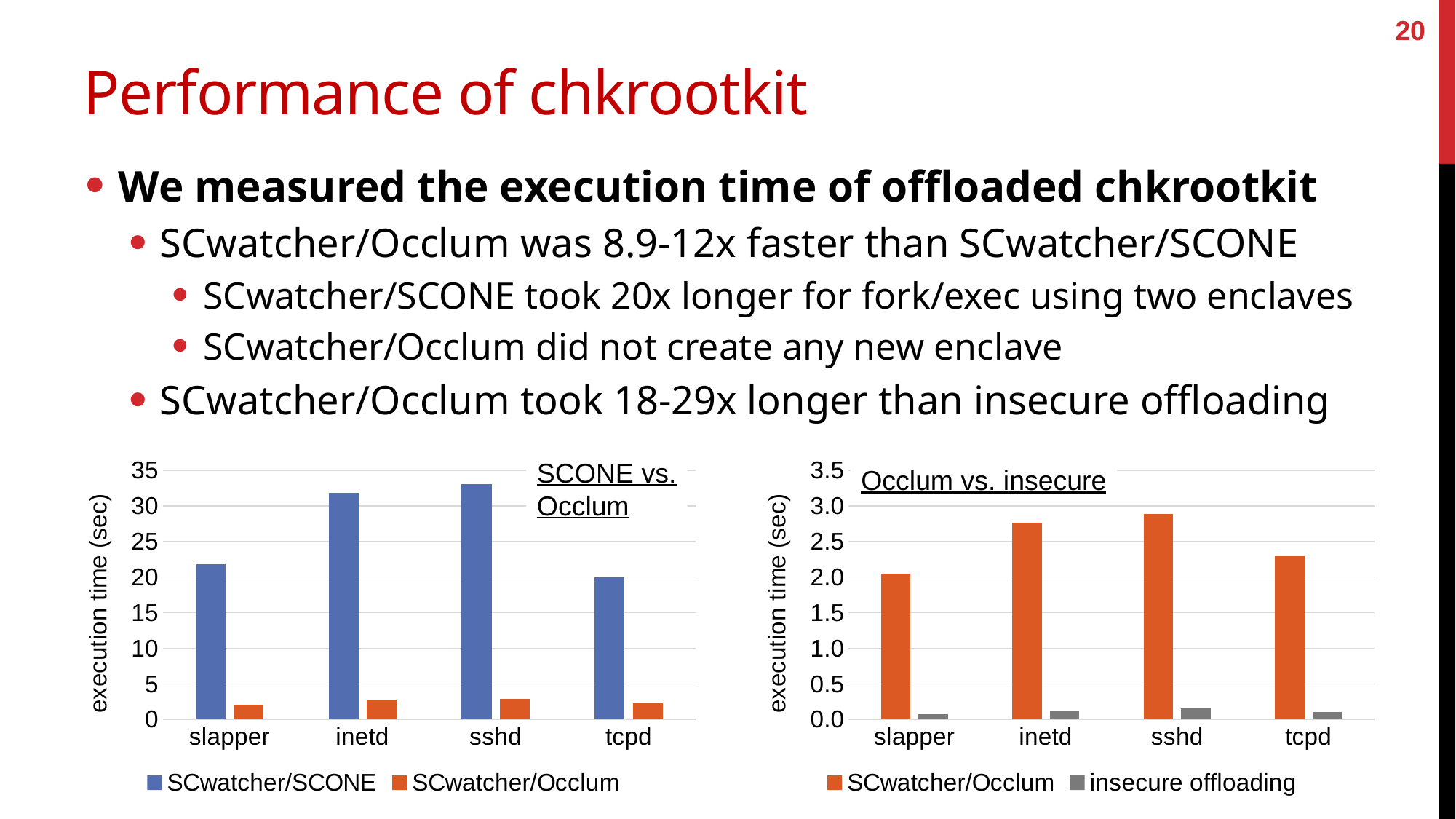
In the 'SCONE vs. Occlum' chart, how many categories are on the x axis? 4 In the 'SCONE vs. Occlum' chart, is the SCwatcher/Occlum value for sshd greater or less than 5? less In the 'Occlum vs. insecure' chart, which category has the lowest SCwatcher/Occlum value? slapper What is the y-axis label of the 'Occlum vs. insecure' chart? execution time (sec) In the 'SCONE vs. Occlum' chart, is the SCwatcher/SCONE value for inetd greater or less than 30? greater In the 'SCONE vs. Occlum' chart, is the SCwatcher/SCONE value for tcpd greater or less than 25? less In the 'SCONE vs. Occlum' chart, what kind of chart is shown? bar chart In the 'SCONE vs. Occlum' chart, which series has the larger value for slapper, SCwatcher/SCONE or SCwatcher/Occlum? SCwatcher/SCONE In the 'SCONE vs. Occlum' chart, how many series does the legend list? 2 In the 'Occlum vs. insecure' chart, which series does the grey bar represent? insecure offloading